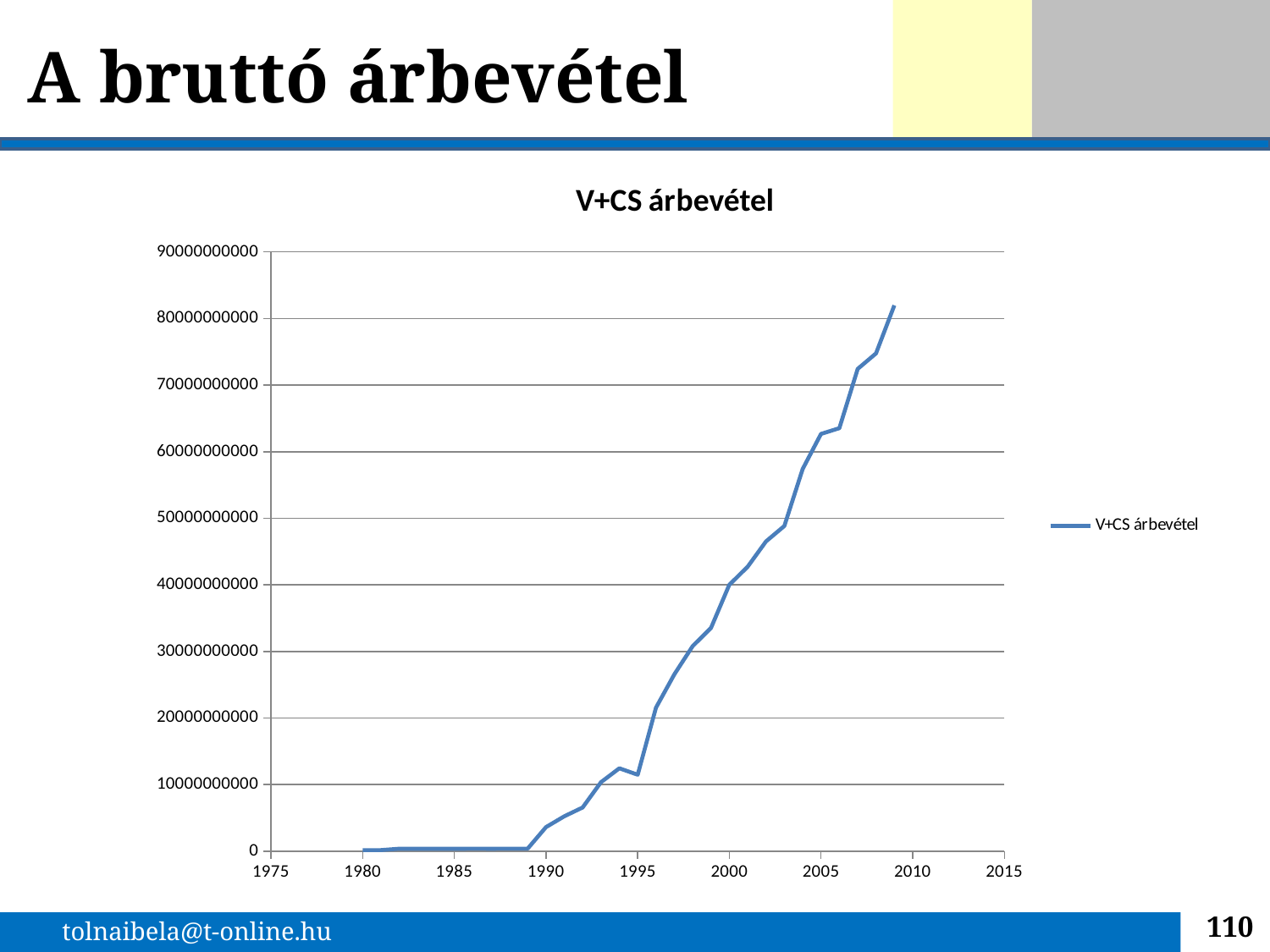
What is the highest value shown on the y axis? 90000000000 Is the value for 1990 greater or less than 10000000000? less Is the value for 2005 greater or less than 50000000000? greater Which is larger, the value for 2005 or the value for 1995? 2005 How many series does the legend list? 1 Is the value for 1995 greater or less than 20000000000? less What is the title of the chart? V+CS árbevétel What kind of chart is shown on the slide? line chart Do the values generally rise or fall from 1990 to 2010? rise